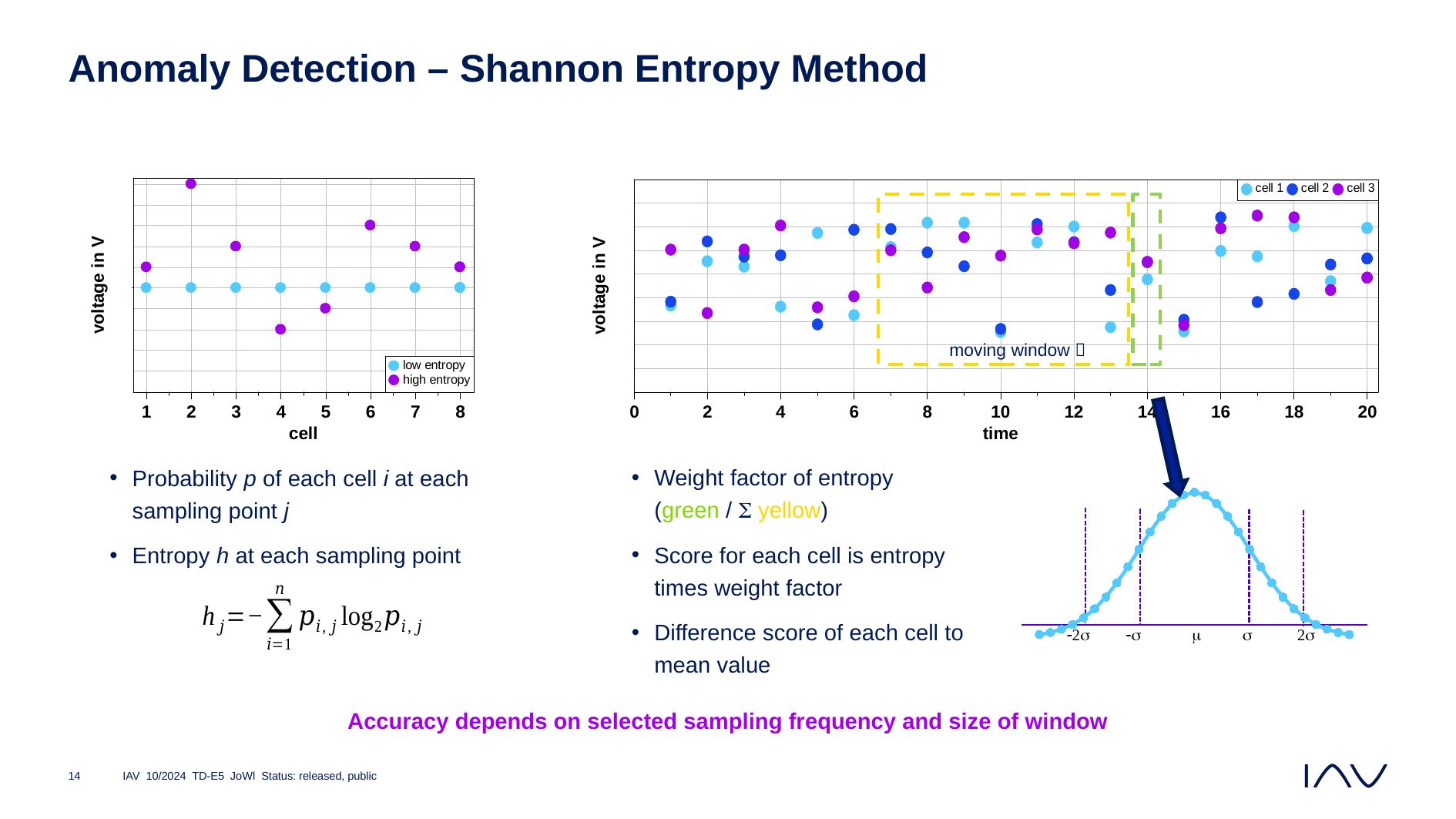
What kind of chart is the left chart with the x axis labelled 'cell'? scatter chart What is the x-axis label of the right chart? time In the left chart, which cell has the highest 'high entropy' value? 2 In the left chart, do the 'low entropy' values rise, fall or stay constant across cells 1 to 8? stay constant How many series does the legend of the right chart (voltage vs time) list? 3 How many cells are plotted along the x axis of the left chart? 8 How many series does the legend of the left chart (voltage vs cell) list? 2 What are the two legend entries of the left chart (voltage vs cell)? low entropy, high entropy What kind of chart is the right chart with the x axis labelled 'time'? scatter chart In the left chart, at cell 6, which series has the larger value, 'low entropy' or 'high entropy'? high entropy In the right chart, at time 2, which series has the larger value, cell 2 or cell 3? cell 2 In the left chart, which cell has the lowest 'high entropy' value? 4